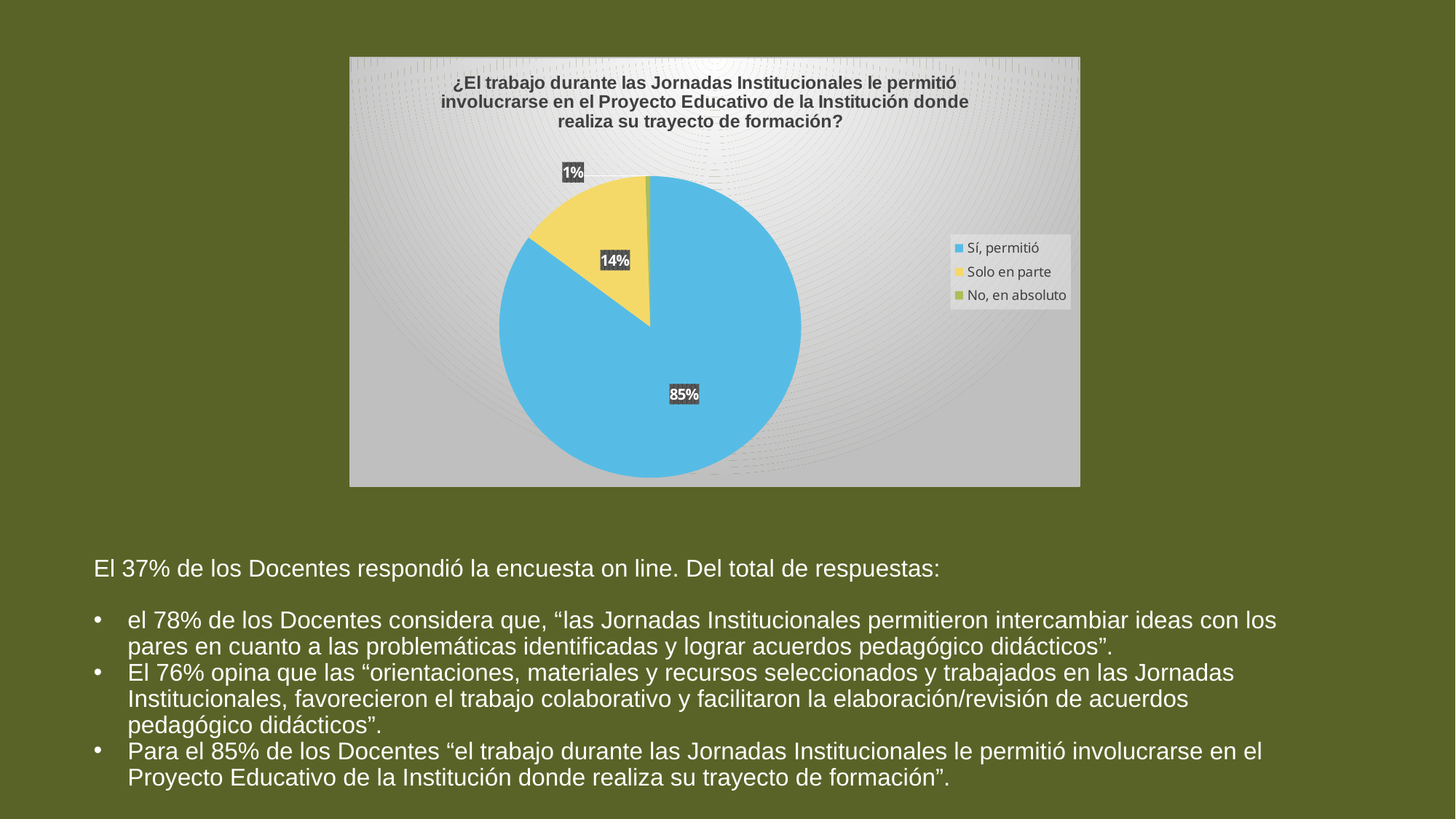
How many categories does the pie chart show? 3 What colour is the slice for "Solo en parte"? yellow What share of the pie does "Solo en parte" represent? 14% Which category has the largest slice of the pie? Sí, permitió What colour is the slice for "Sí, permitió"? blue What kind of chart is shown on the slide? pie chart What share of the pie does "No, en absoluto" represent? 1% What share of the pie does "Sí, permitió" represent? 85% What is the difference in percentage points between "Sí, permitió" and "Solo en parte"? 71 Which category has the smallest slice of the pie? No, en absoluto How many entries does the legend list? 3 Which is larger, the slice for "Solo en parte" or the slice for "No, en absoluto"? Solo en parte